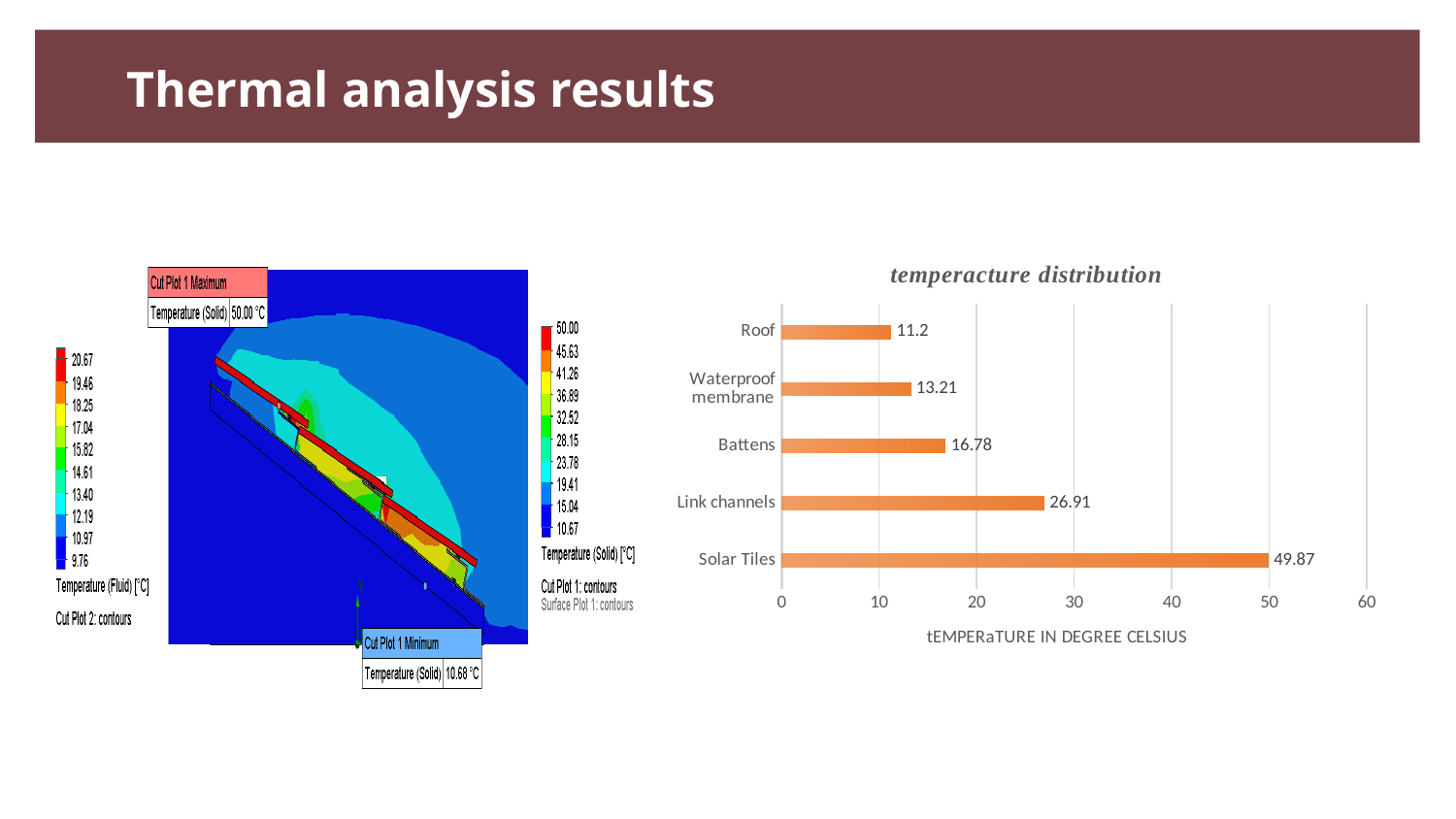
In the bar chart, what is the difference between the values for Solar Tiles and Link channels? 22.96 In the bar chart, what is the value for Waterproof membrane? 13.21 In the bar chart, what is the difference between the values for Battens and Roof? 5.58 What kind of chart is the chart titled "temperacture distribution"? bar chart In the bar chart, what is the value for Link channels? 26.91 In the bar chart, which category has the lowest value? Roof How many categories are shown in the bar chart? 5 In the bar chart, what is the value for Solar Tiles? 49.87 In the bar chart, which category has the highest value? Solar Tiles In the bar chart, is the value for Link channels greater or less than 30? less What is the x-axis label of the bar chart? tEMPERaTURE IN DEGREE CELSIUS In the bar chart, which is larger, the value for Battens or the value for Waterproof membrane? Battens